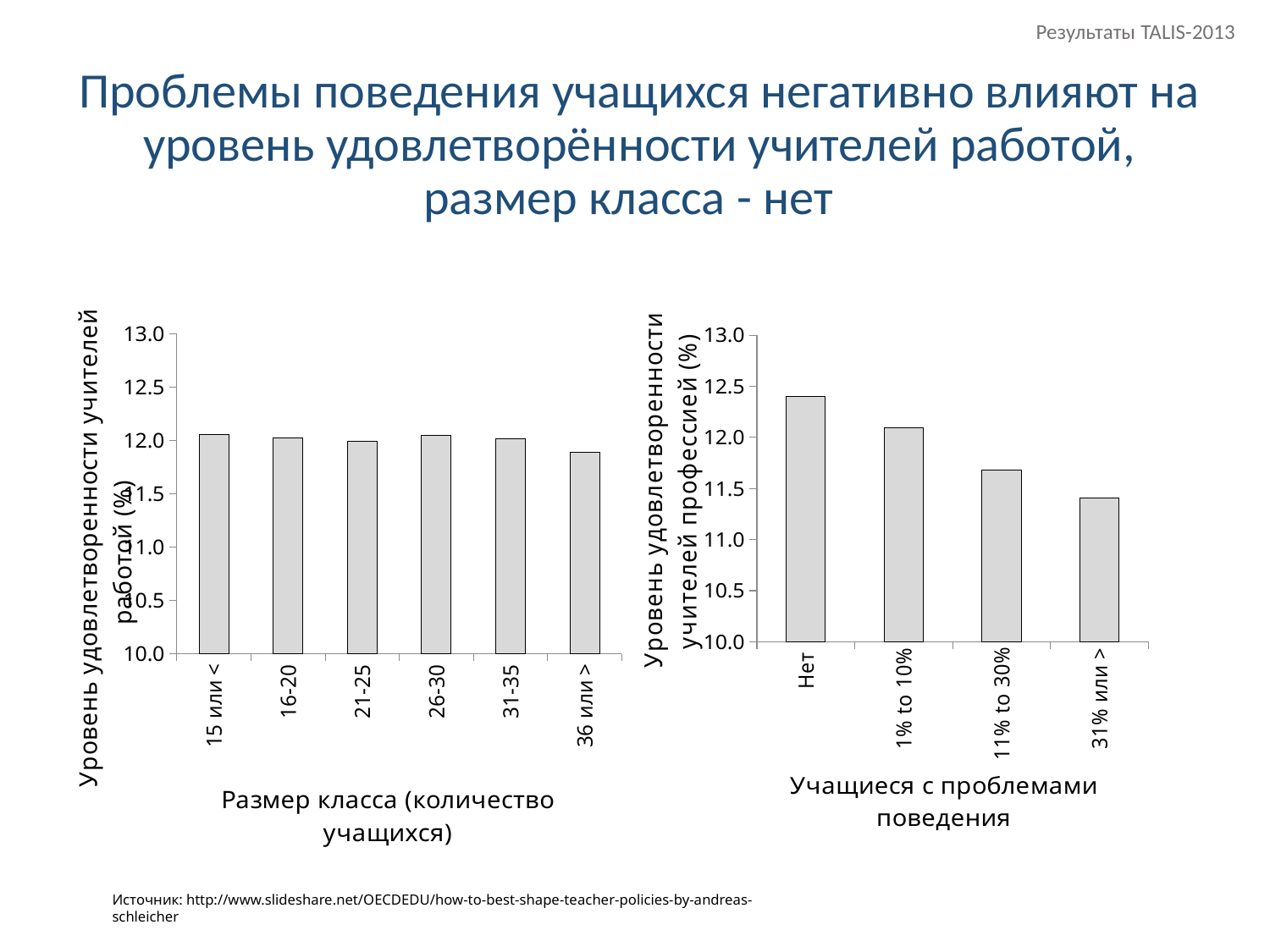
How many categories are shown on the right chart (students with behaviour problems)? 4 On the left chart, is the value for '36 или >' greater or less than 12.0? less How many class-size categories are shown on the left chart? 6 On the right chart, which category has the lowest teacher satisfaction level? 31% или > On the left chart, which class-size category has the lowest teacher satisfaction level? 36 или > On the right chart, which is larger, the value for '1% to 10%' or the value for '11% to 30%'? 1% to 10% What kind of chart is the left chart (class size)? bar chart What is the x-axis title of the right chart? Учащиеся с проблемами поведения On the right chart, do the values rise or fall as the share of students with behaviour problems increases along the x axis? fall On the right chart, is the value for '31% или >' greater or less than 11.5? less On the right chart, is the value for 'Нет' greater or less than 12.0? greater On the right chart, which category has the highest teacher satisfaction level? Нет